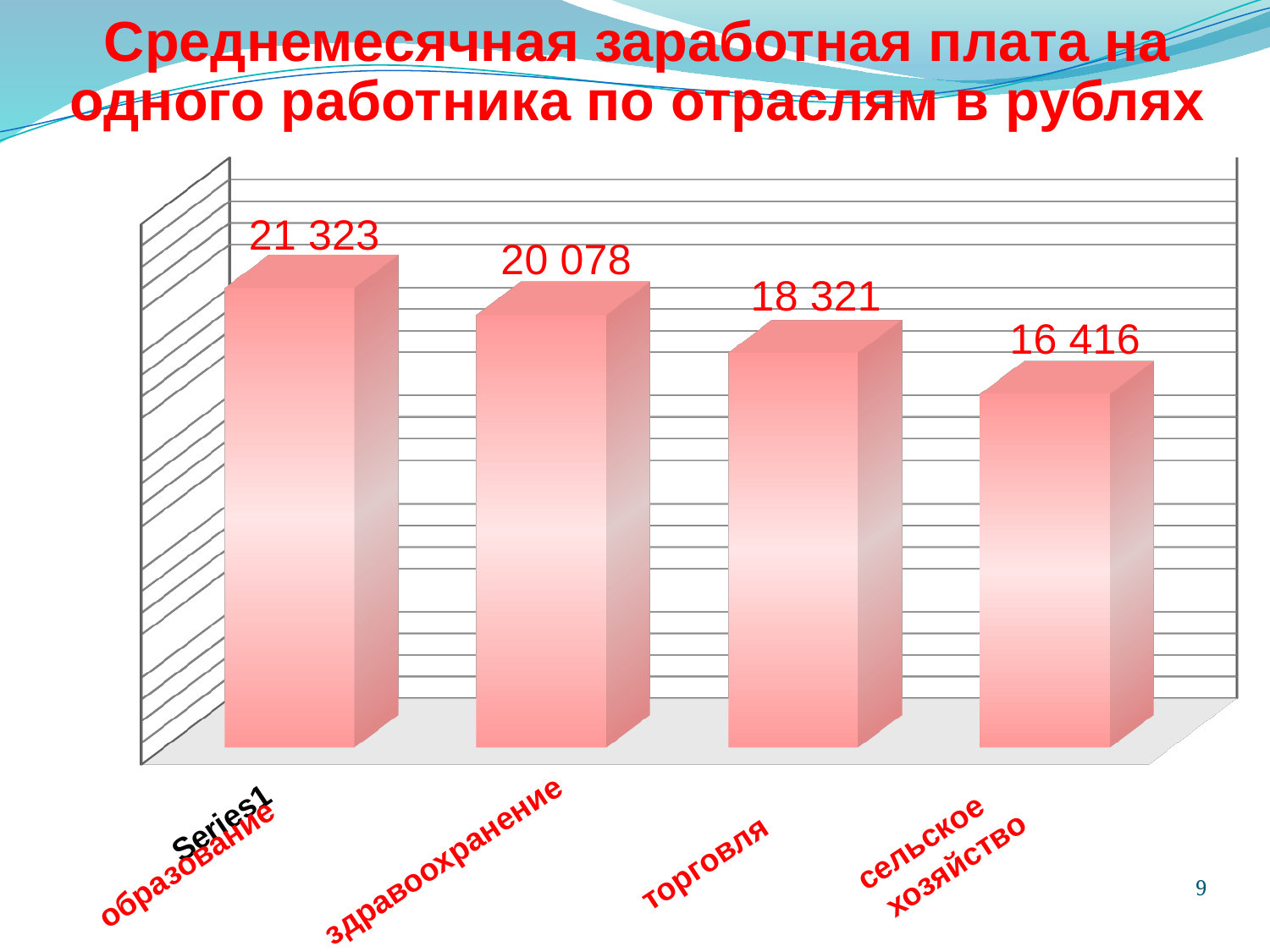
How many sectors are shown in the chart? 4 What kind of chart is shown on the slide? bar chart Which sector has the lowest average monthly salary? сельское хозяйство What is the difference between the values for образование and сельское хозяйство? 4 907 Which sector has the highest average monthly salary? образование Which is larger, the value for торговля or the value for здравоохранение? здравоохранение What is the average monthly salary for образование? 21 323 What is the value shown for торговля? 18 321 What is the value shown for здравоохранение? 20 078 What is the difference between the values for здравоохранение and торговля? 1 757 Do the values rise or fall from left to right across the categories? fall What is the value shown for сельское хозяйство? 16 416